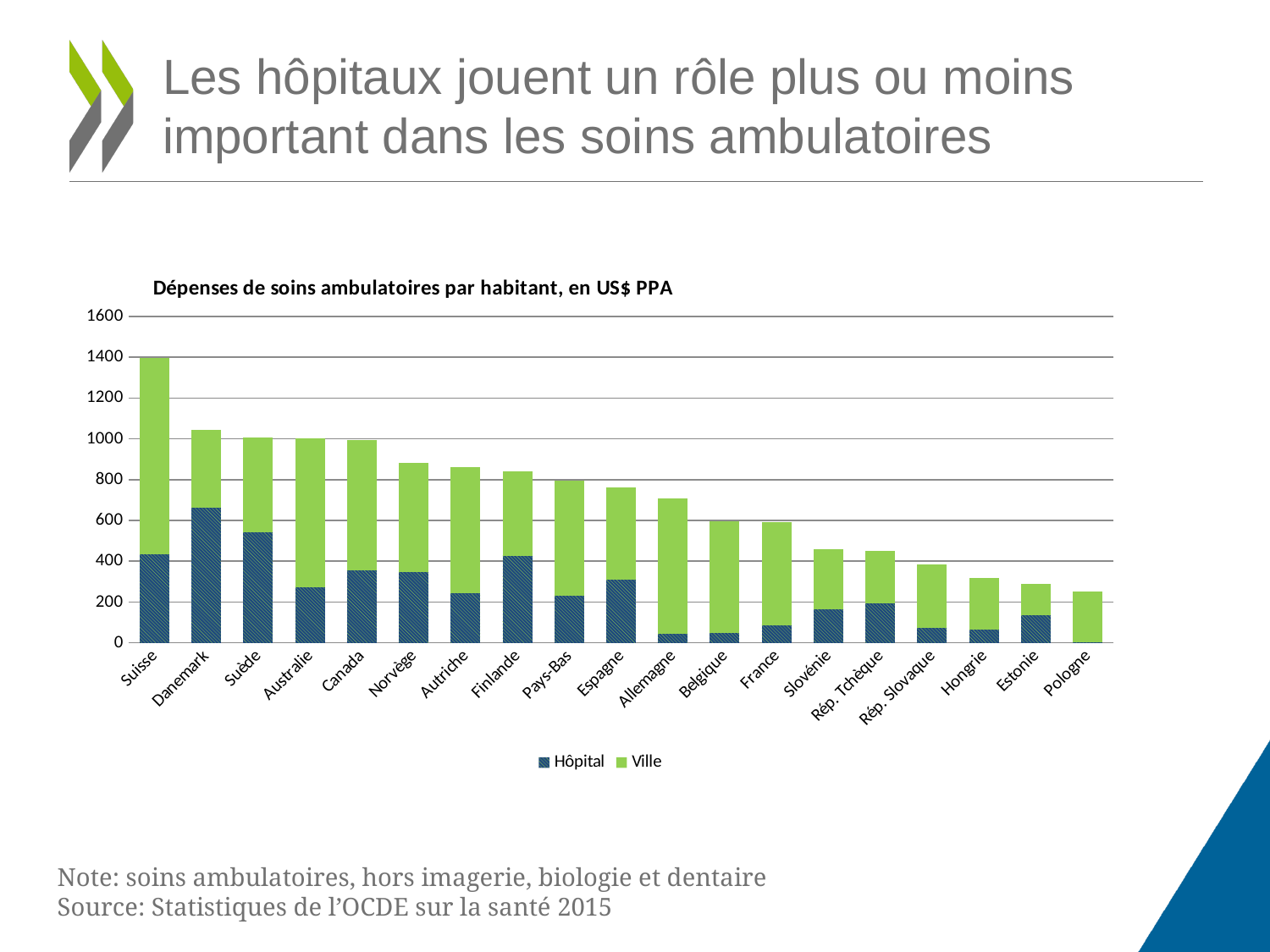
How many series does the chart's legend list? 2 What kind of chart is shown on the slide? Stacked bar chart Which country has the highest total ambulatory care spending per capita in the chart? Suisse Is the total value for Hongrie greater or less than 400? less How many countries are shown on the x axis of the chart? 19 What is the title of the chart? Dépenses de soins ambulatoires par habitant, en US$ PPA Do the total bar heights rise or fall moving from left to right along the x axis? Fall Is the Hôpital value for Danemark greater or less than 600? greater Which country has the lowest total ambulatory care spending per capita in the chart? Pologne Which country has the largest Hôpital segment in the chart? Danemark Which has the larger Hôpital value, Danemark or Suède? Danemark Is the total value for Suisse greater or less than 1200? greater